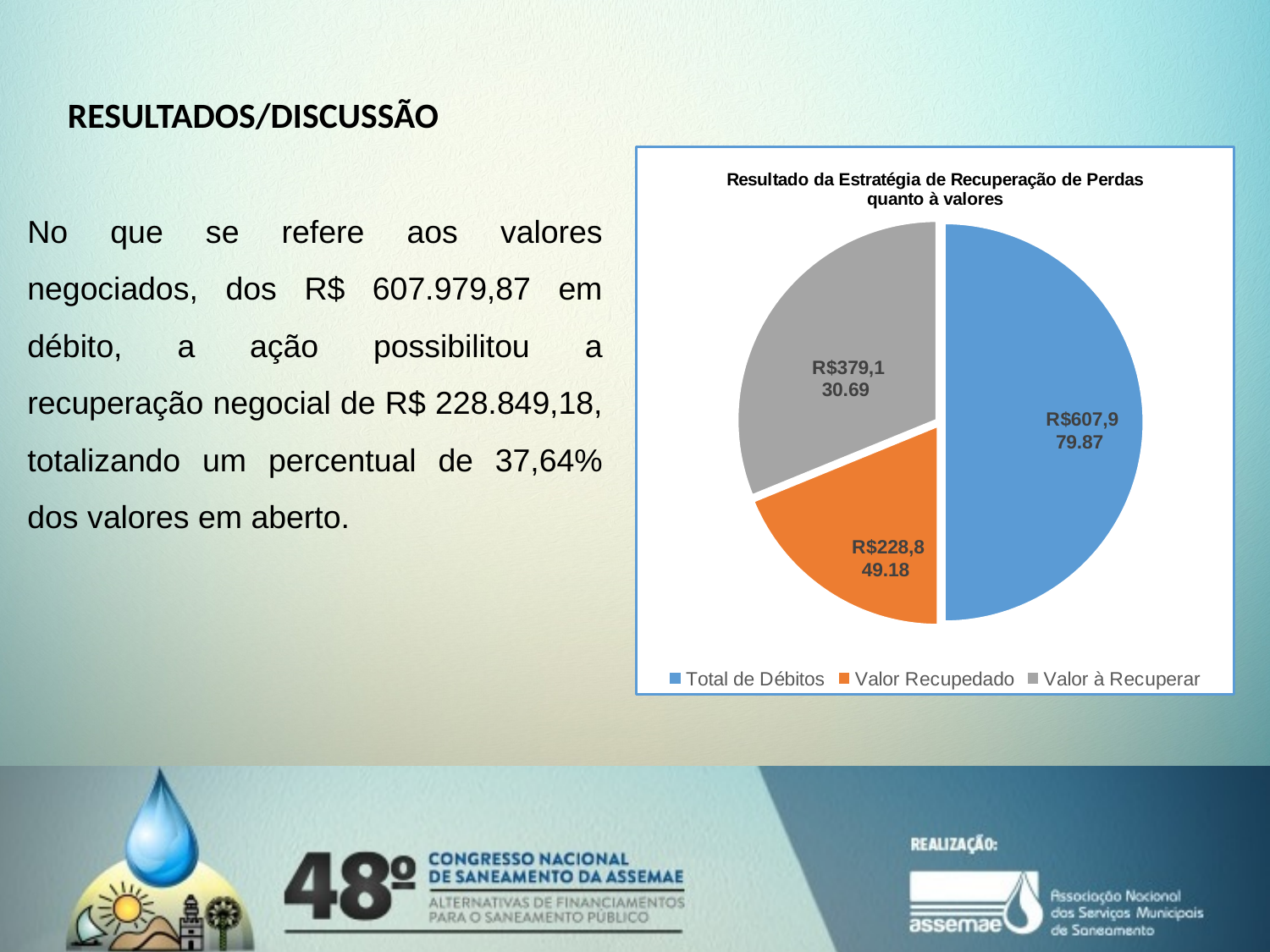
What value is shown for Total de Débitos? R$607,979.87 What is the difference between Total de Débitos and Valor Recupedado? R$379,130.69 Which slice of the pie is the smallest? Valor Recupedado What colour is the Total de Débitos slice? blue How many entries does the chart legend list? 3 Which is larger, Valor à Recuperar or Valor Recupedado? Valor à Recuperar What is the title of the chart? Resultado da Estratégia de Recuperação de Perdas quanto à valores What value is shown for Valor à Recuperar? R$379,130.69 How many slices does the pie chart have? 3 Which slice of the pie is the largest? Total de Débitos What value is shown for Valor Recupedado? R$228,849.18 What kind of chart is shown on the slide? pie chart